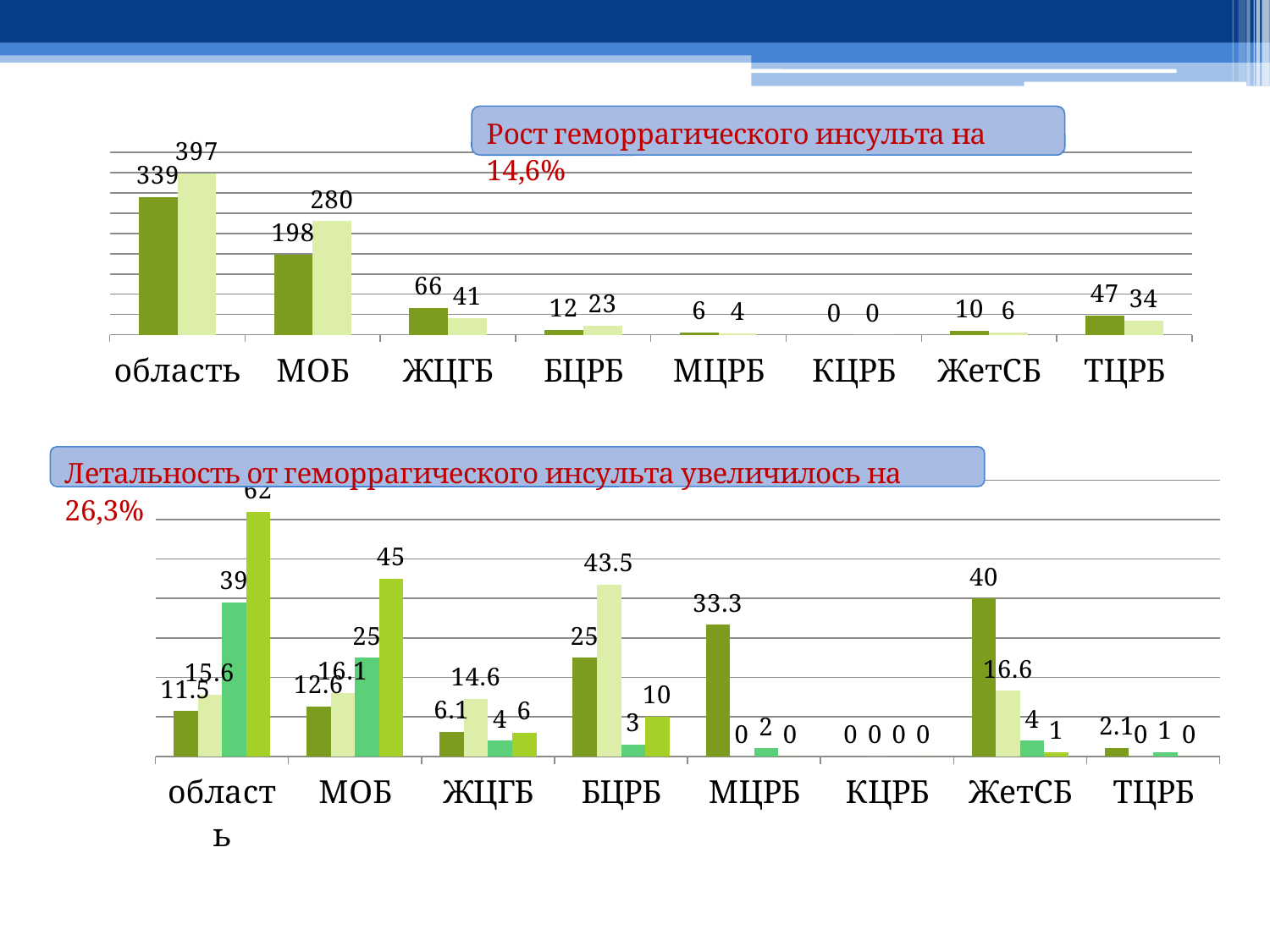
In the top chart, what is the value of the first (dark green) bar for область? 339 In the top chart, what is the difference between the two bars for область? 58 In the top chart, which category has the highest value for the first (dark green) series? область In the top chart, which is larger for ЖЦГБ: the first (dark green) bar or the second (light green) bar? the first (dark green) bar In the bottom chart, what is the difference between the fourth bar (45) and the third bar (25) for МОБ? 20 In the top chart, what is the value of the second (light green) bar for МОБ? 280 In the bottom chart, what is the value of the second (light green) bar for БЦРБ? 43.5 In the bottom chart, which category has the tallest bar overall? область How many categories are shown on the x axis of the top chart? 8 What kind of chart is the bottom chart? bar chart In the bottom chart, what is the value of the first (dark green) bar for ЖетСБ? 40 In the bottom chart, what is the value of the fourth (bright green) bar for область? 62